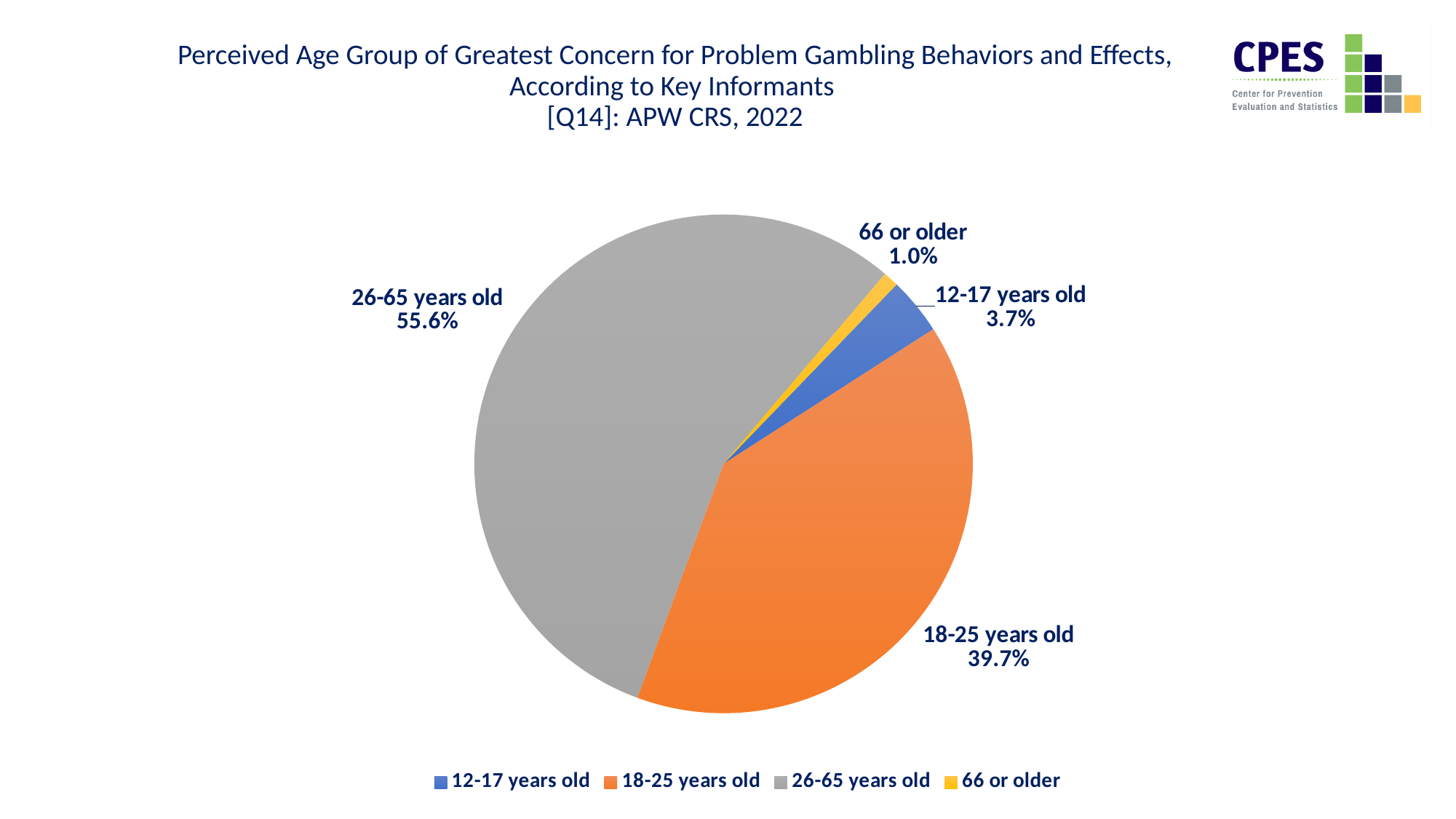
What colour is the slice for 18-25 years old? Orange What is the difference in percentage points between the 26-65 years old slice and the 18-25 years old slice? 15.9 What percentage is shown for the 66 or older slice? 1.0% How many age group categories are shown in the pie chart? 4 Which age group has the smallest slice of the pie? 66 or older Which age group has the largest slice of the pie? 26-65 years old What is the combined percentage of the 12-17 years old and 66 or older slices? 4.7% What percentage of key informants identified 26-65 years old as the age group of greatest concern? 55.6% What kind of chart is shown on the slide? Pie chart What is the value shown for the 12-17 years old slice? 3.7% Which slice is larger: 12-17 years old or 66 or older? 12-17 years old What share of the pie is labelled 18-25 years old? 39.7%